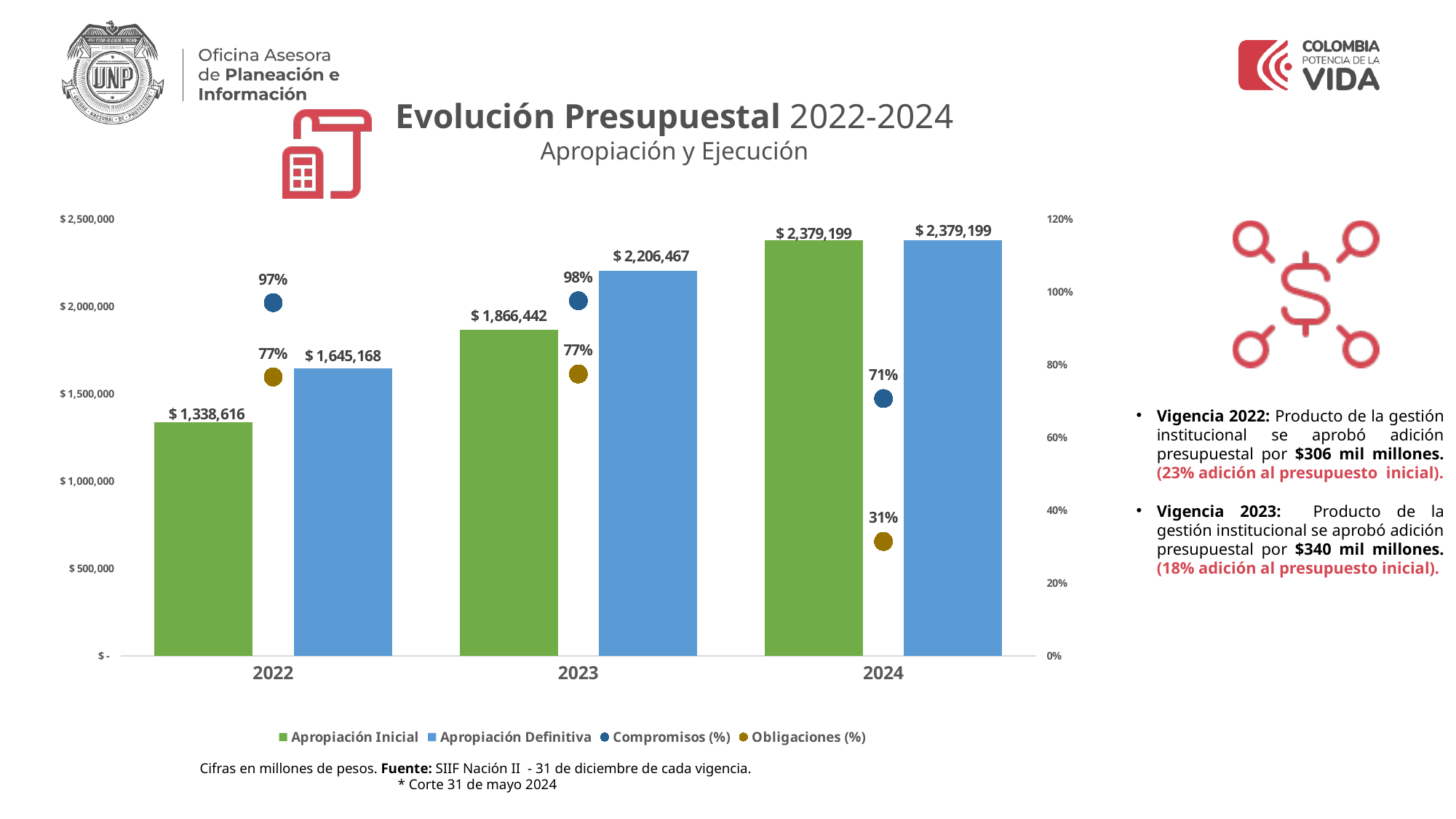
Is the Apropiación Inicial for 2023 greater or less than $ 2,000,000? less Which year has the lowest Obligaciones (%)? 2024 What is the Apropiación Inicial value for 2022? $ 1,338,616 What is the Obligaciones (%) value for 2022? 77% What is the Compromisos (%) value for 2024? 71% Is the Compromisos (%) value for 2023 larger than the Compromisos (%) value for 2024? Yes Does the Apropiación Inicial rise or fall from 2022 to 2024? Rise How many series does the legend list? 4 Which year has the highest Apropiación Definitiva? 2024 What is the difference between Apropiación Definitiva and Apropiación Inicial in 2022? $ 306,552 How many years are shown on the x axis? 3 What is the Apropiación Definitiva value for 2023? $ 2,206,467